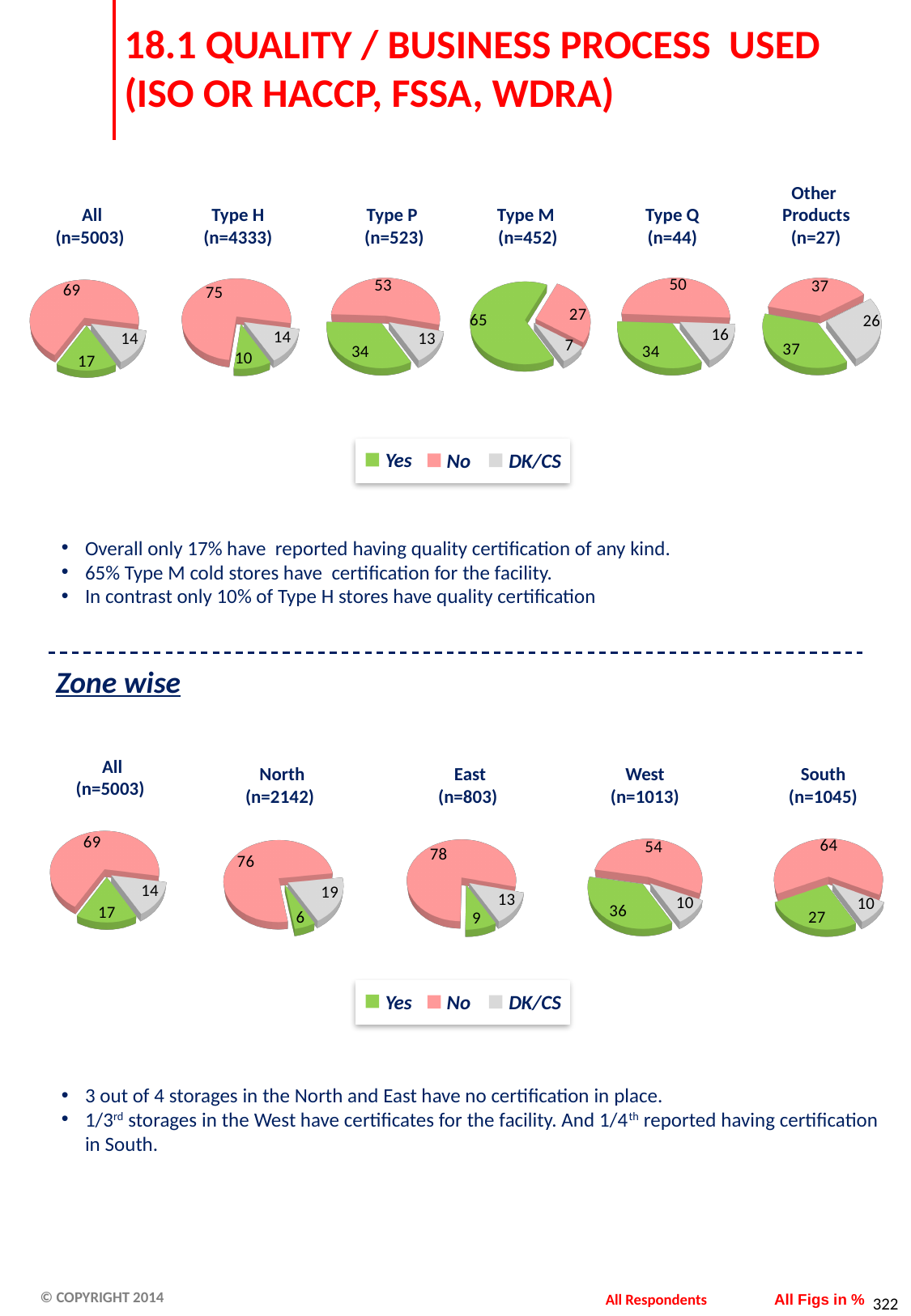
In the Type P (n=523) pie chart, which category has the largest slice? No In the Type M (n=452) pie chart, which category has the smallest slice? DK/CS In the Other Products (n=27) pie chart, what is the value for DK/CS? 26 In the Zone wise North (n=2142) pie chart, what is the value for DK/CS? 19 In the Type M (n=452) pie chart, what is the value for Yes? 65 Which is larger in the South (n=1045) pie chart: the Yes slice or the DK/CS slice? Yes In the West (n=1013) pie chart, what is the value for Yes? 36 What type of chart is used for the Type Q (n=44) data? Pie chart How many series does the legend list for the pie charts? 3 In the East (n=803) pie chart, what is the difference between the No value and the Yes value? 69 How many pie charts are shown in the Zone wise section? 5 In the Type H (n=4333) pie chart, what is the value for No? 75